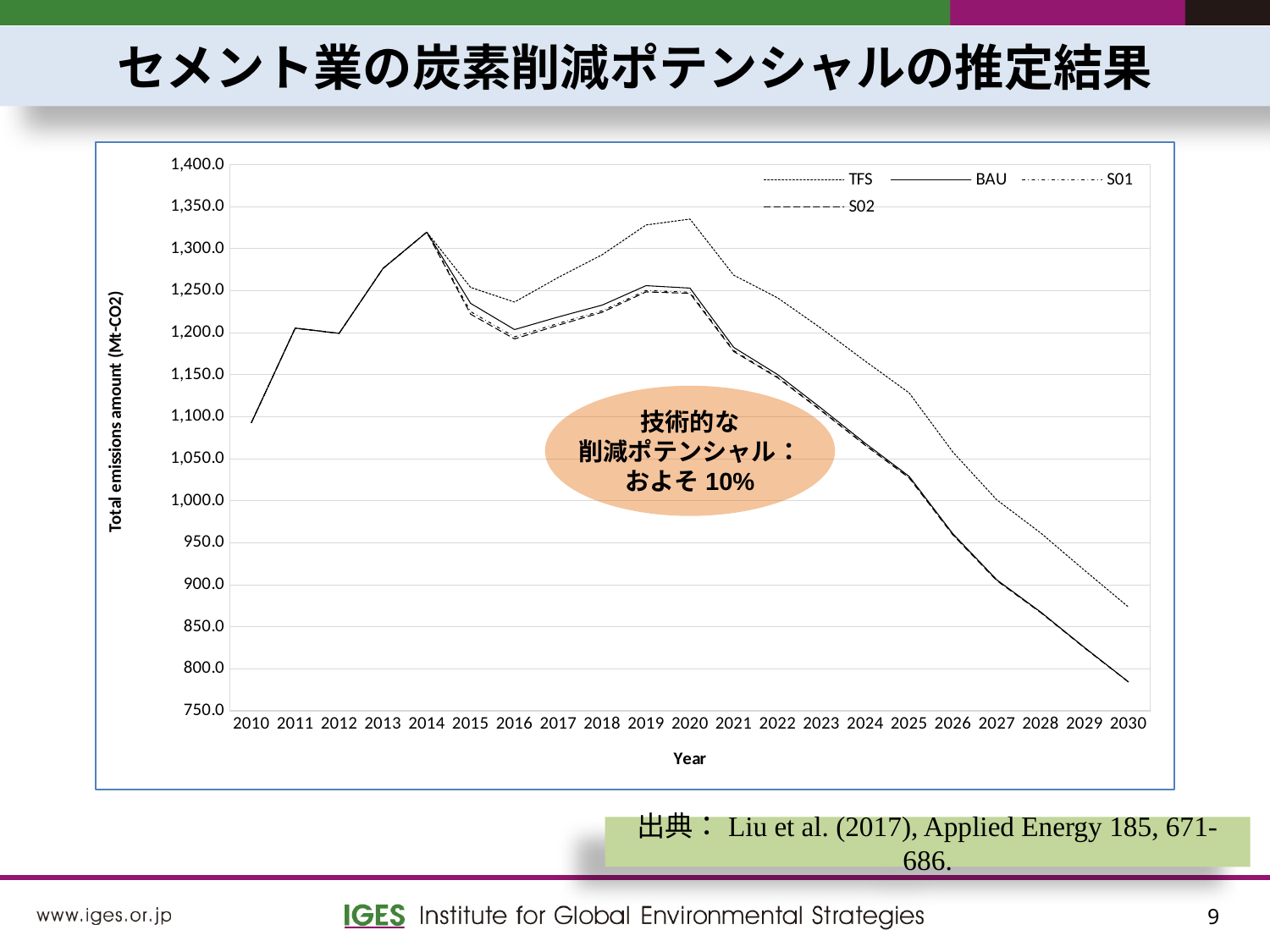
In 2030, which series has the larger value, TFS or BAU? TFS In which year does the BAU series reach its lowest value? 2030 What kind of chart is shown on the slide? line chart Do the BAU values rise or fall from 2020 to 2030? fall Is the BAU value in 2030 greater or less than 800? less Is the TFS value in 2030 greater or less than 850? greater What is the label of the chart's y axis? Total emissions amount (Mt-CO2) Is the BAU value in 2025 greater or less than 1,000? greater How many years are plotted along the x axis of the chart? 21 How many series does the chart's legend list? 4